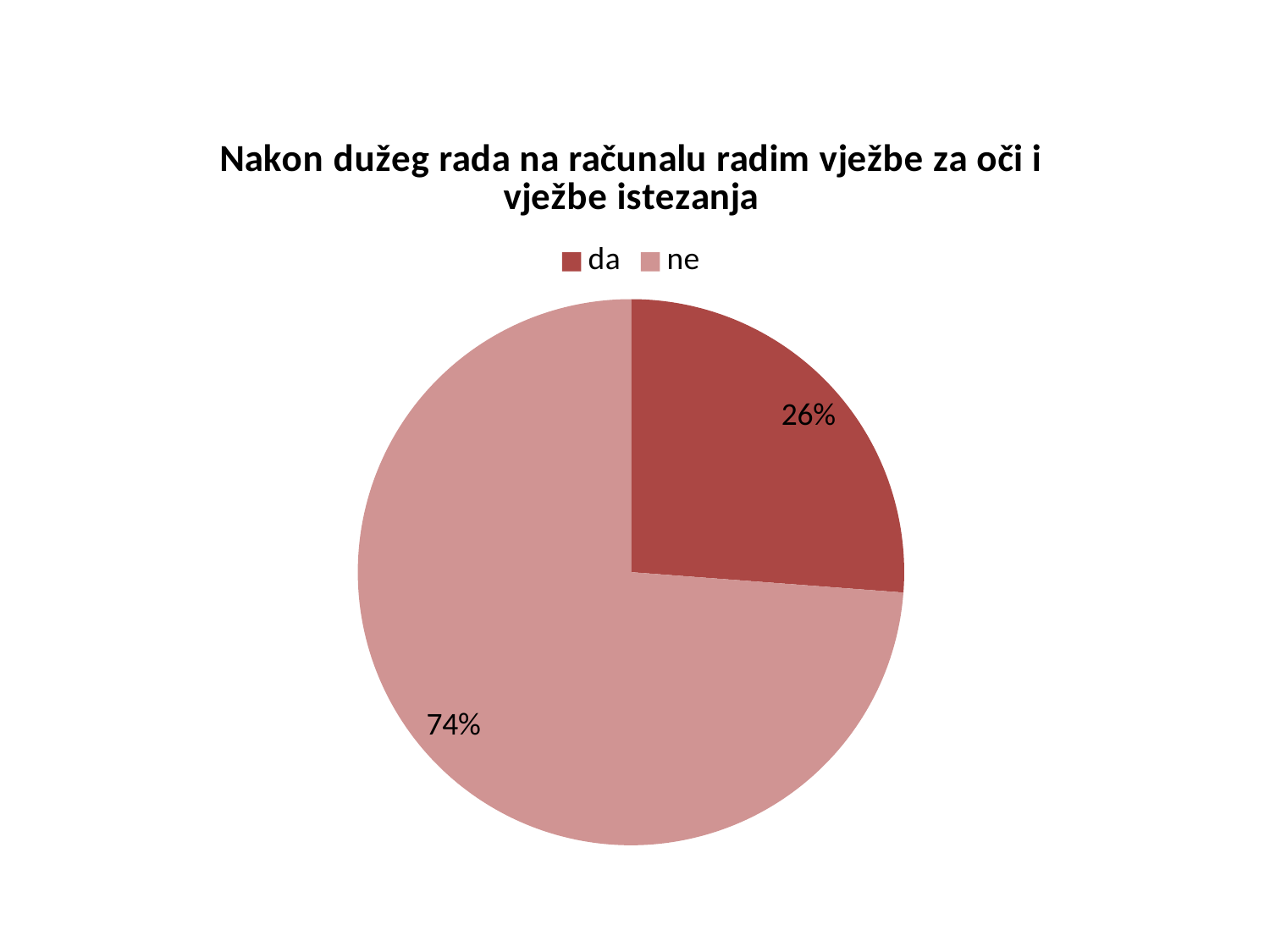
What kind of chart is shown on the slide? pie chart How many entries does the legend list? 2 What is the difference in percentage points between the "ne" and "da" slices? 48 What percentage of respondents answered "da"? 26% Which legend entry is shown in the darker red colour? da Which is larger, the share for "da" or the share for "ne"? ne What percentage of respondents answered "ne"? 74% Which category has the largest share of the pie? ne Which category has the smallest share of the pie? da What share of the pie does the "da" slice represent? 26% What is the title of the chart? Nakon dužeg rada na računalu radim vježbe za oči i vježbe istezanja How many slices does the pie chart have? 2